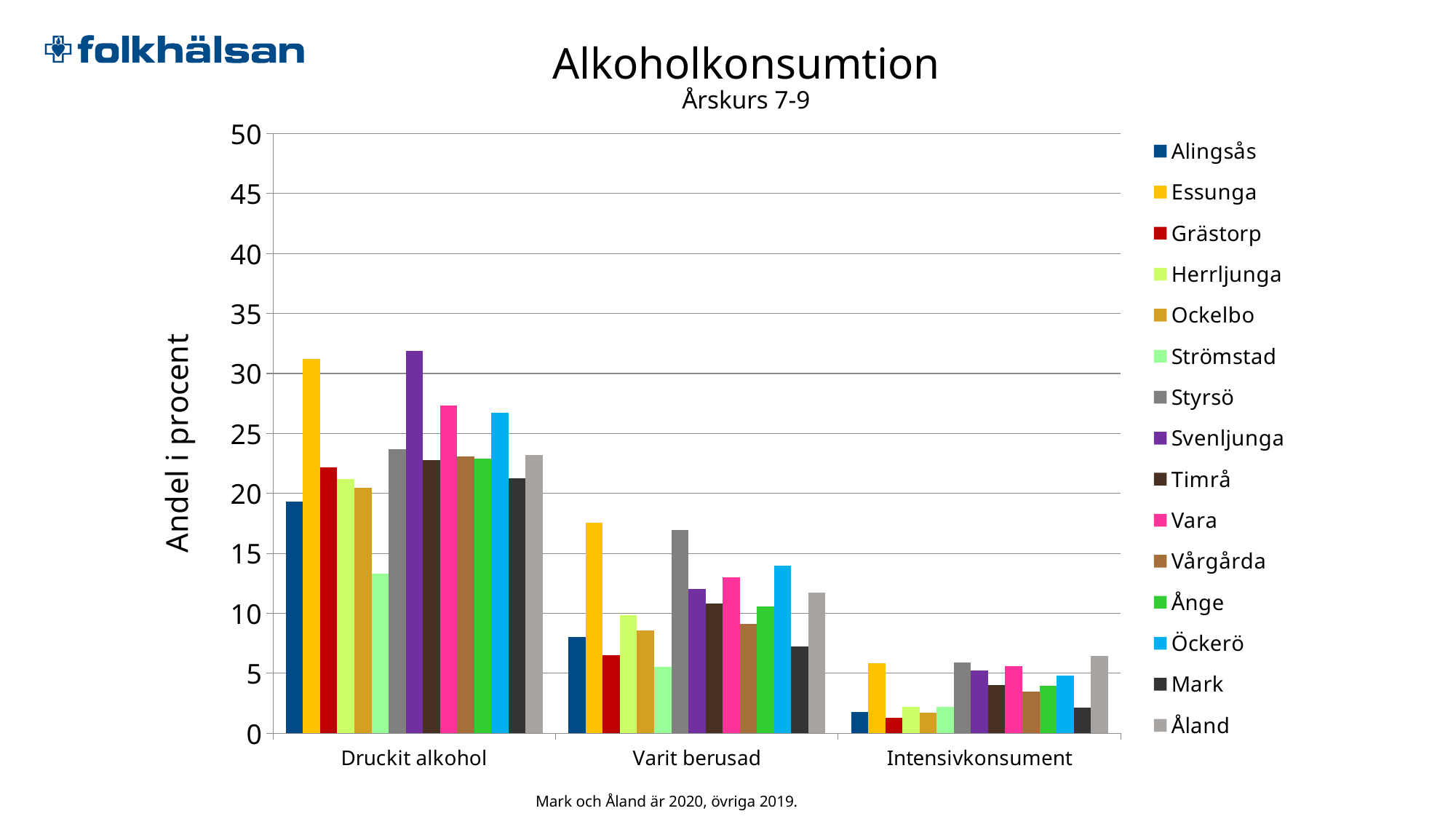
What is the title of the y axis? Andel i procent Which series has the lowest value for Druckit alkohol? Strömstad Is the value for Styrsö in Varit berusad greater or less than 15? greater How many series does the legend list? 15 Which is larger for Druckit alkohol, Essunga or Alingsås? Essunga How many categories are shown on the x axis? 3 Is the value for Essunga in Druckit alkohol greater or less than 30? greater Which series has the lowest value for Intensivkonsument? Grästorp Which is larger for Varit berusad, Vara or Timrå? Vara Is the value for Alingsås in Varit berusad greater or less than 10? less Which series has the lowest value for Varit berusad? Strömstad What kind of chart is shown on the slide? bar chart